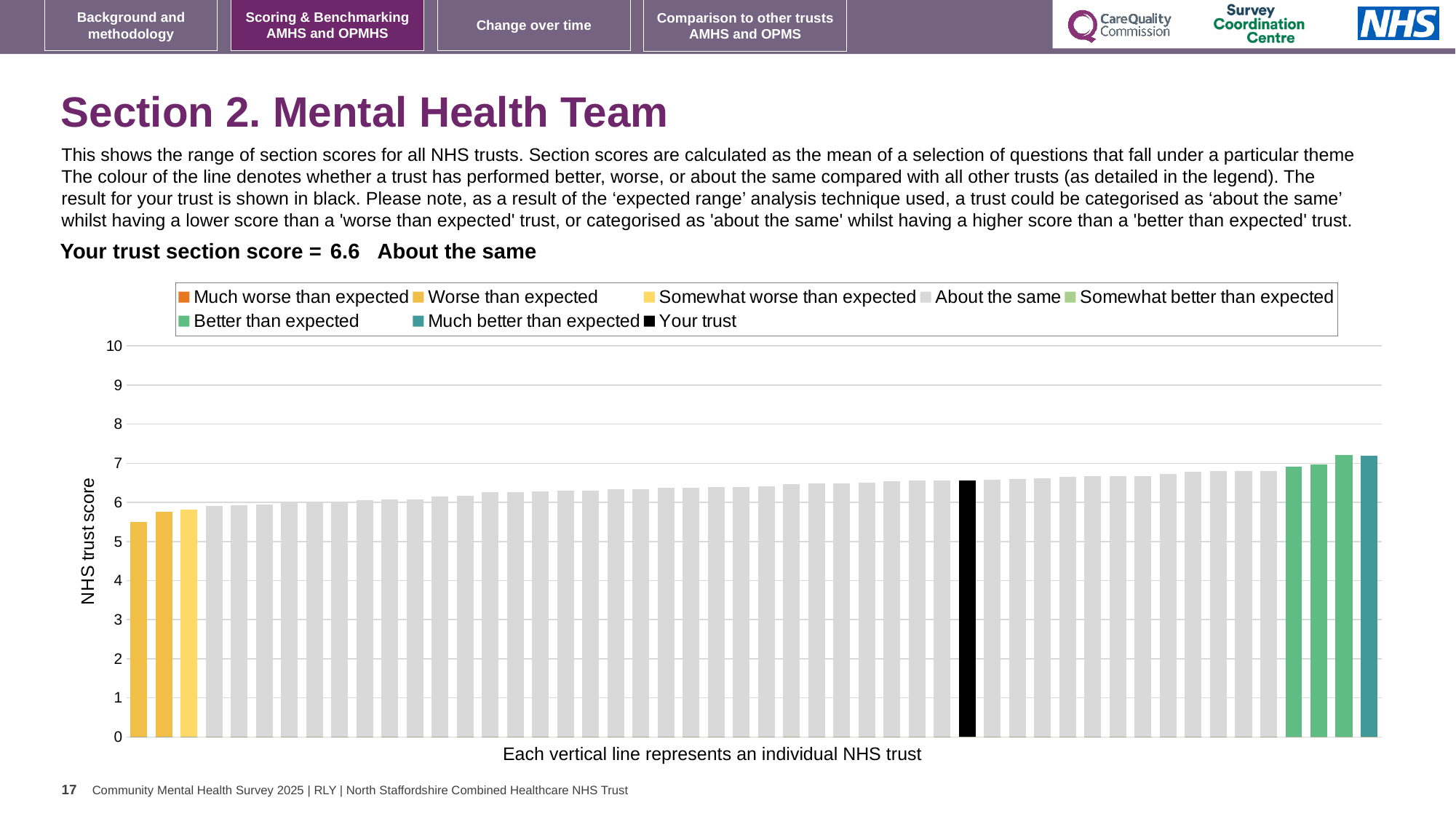
Is the value of the tallest bar greater or less than 8? less Is the value for your trust greater or less than 6? greater Which category is your trust placed in for this section? About the same Is the value of the lowest bar greater or less than 5? greater What colour is used for the bar representing your trust? black What is the section score for your trust shown on the slide? 6.6 What kind of chart is shown on the slide? bar chart How many entries does the chart legend list? 8 What is the title of the vertical axis? NHS trust score Do the bar values rise or fall from left to right along the x axis? rise